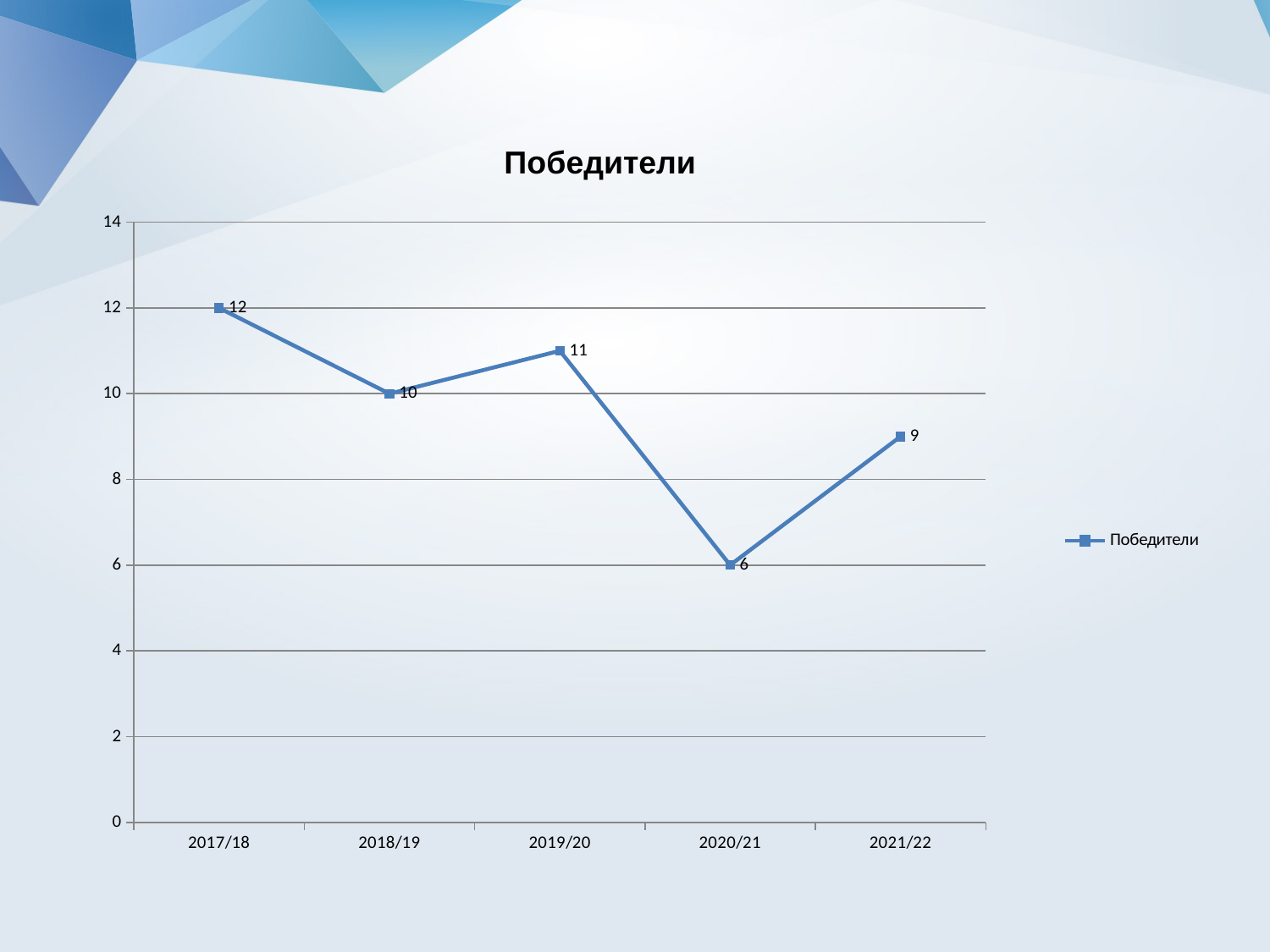
Which year has the highest value? 2017/18 What is the value for 2020/21? 6 Does the value rise or fall from 2020/21 to 2021/22? rise What is the title of the chart? Победители What kind of chart is shown? line chart What is the value for 2017/18? 12 Which year has the lowest value? 2020/21 How many series does the legend list? 1 What is the difference between the values for 2019/20 and 2020/21? 5 Which is larger, the value for 2018/19 or the value for 2021/22? 2018/19 How many years are plotted on the chart? 5 What is the value for 2021/22? 9